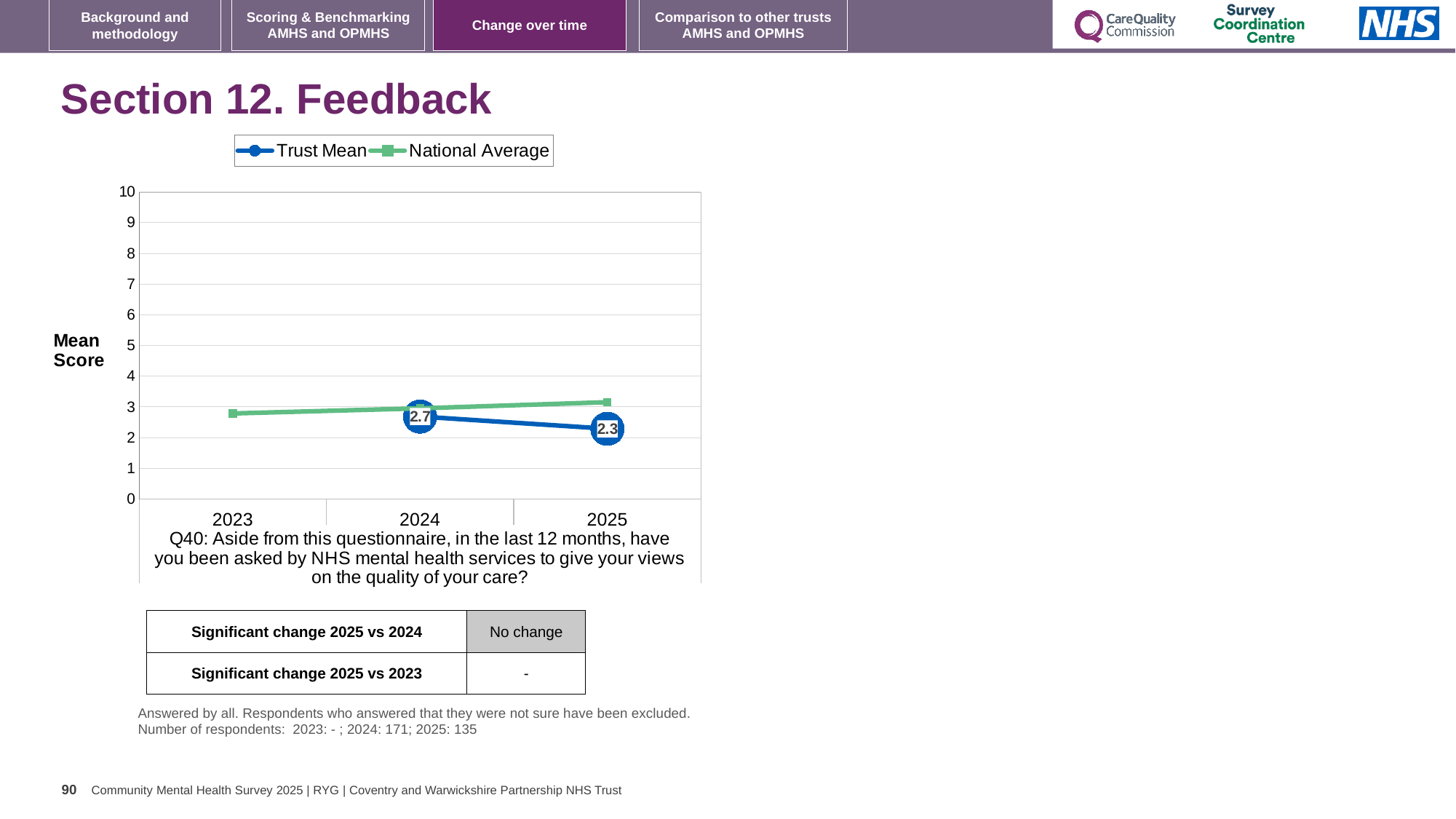
What is the Trust Mean score for 2024? 2.7 Does the Trust Mean rise or fall from 2024 to 2025? fall Is the National Average for 2025 greater or less than 4? less By how much did the Trust Mean score fall from 2024 to 2025? 0.4 What is the Trust Mean score for 2025? 2.3 Does the National Average rise or fall from 2023 to 2025? rise In 2025, which is higher: the Trust Mean or the National Average? National Average How many years are shown on the x axis of the chart? 3 How many series does the chart legend list? 2 What type of chart is shown on the slide? line chart Is the National Average for 2023 greater or less than 2? greater Which year has the lower Trust Mean score, 2024 or 2025? 2025